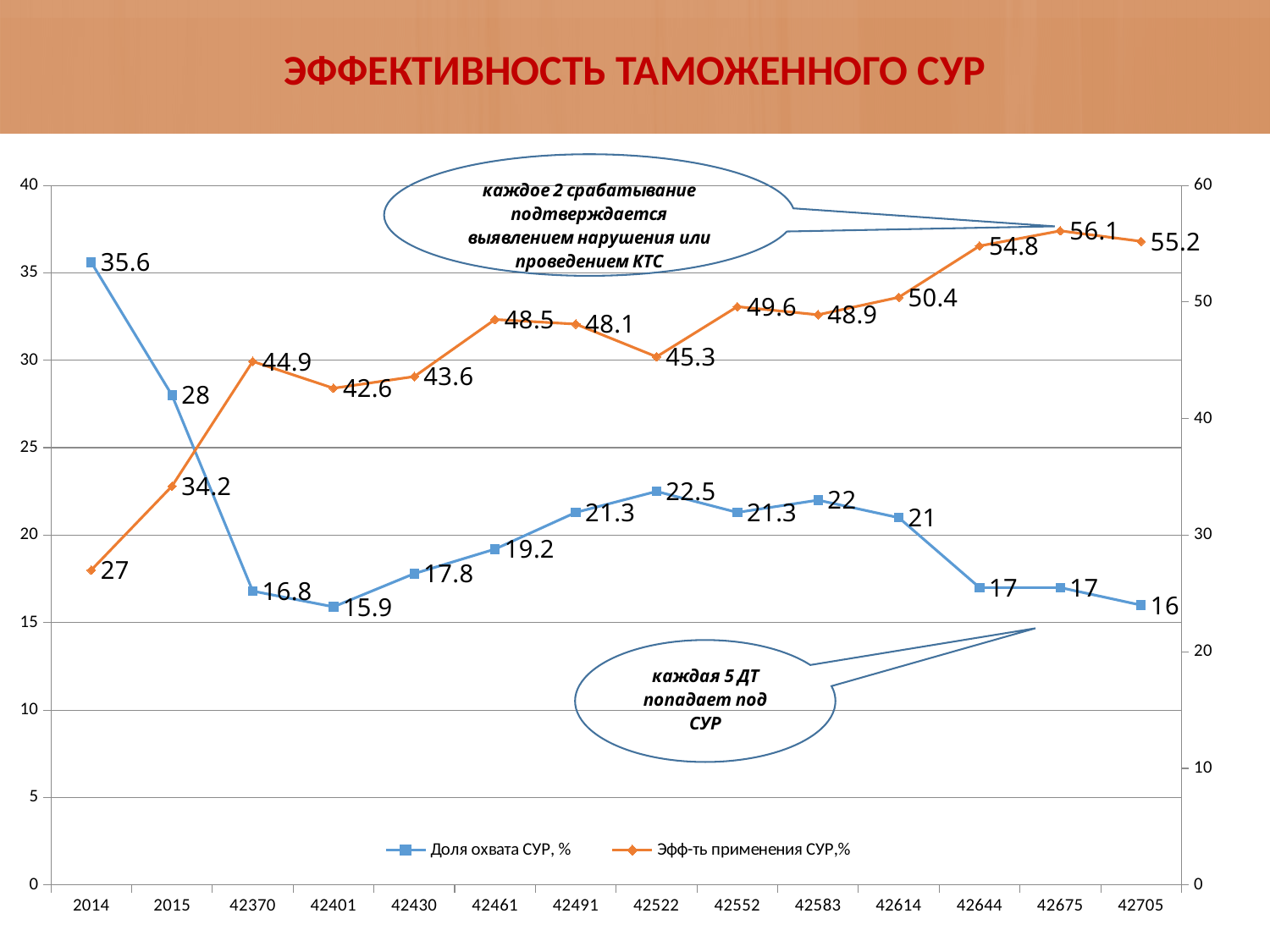
What is the value of "Доля охвата СУР, %" for 2014? 35.6 What is the difference between the "Доля охвата СУР, %" values for 2014 and 2015? 7.6 Which category has the highest value for "Эфф-ть применения СУР,%"? 42675 How many categories are shown on the x axis? 14 Which is larger for "Эфф-ть применения СУР,%": the value for 42370 or the value for 42401? 42370 Which category has the lowest value for "Доля охвата СУР, %"? 42401 What is the value of "Эфф-ть применения СУР,%" for 42675? 56.1 What is the value of "Эфф-ть применения СУР,%" for 2015? 34.2 Does the "Эфф-ть применения СУР,%" series generally rise or fall from 2014 to 42705? Rise How many series does the legend list? 2 What kind of chart is shown on the slide? Line chart What is the value of "Доля охвата СУР, %" for 42522? 22.5